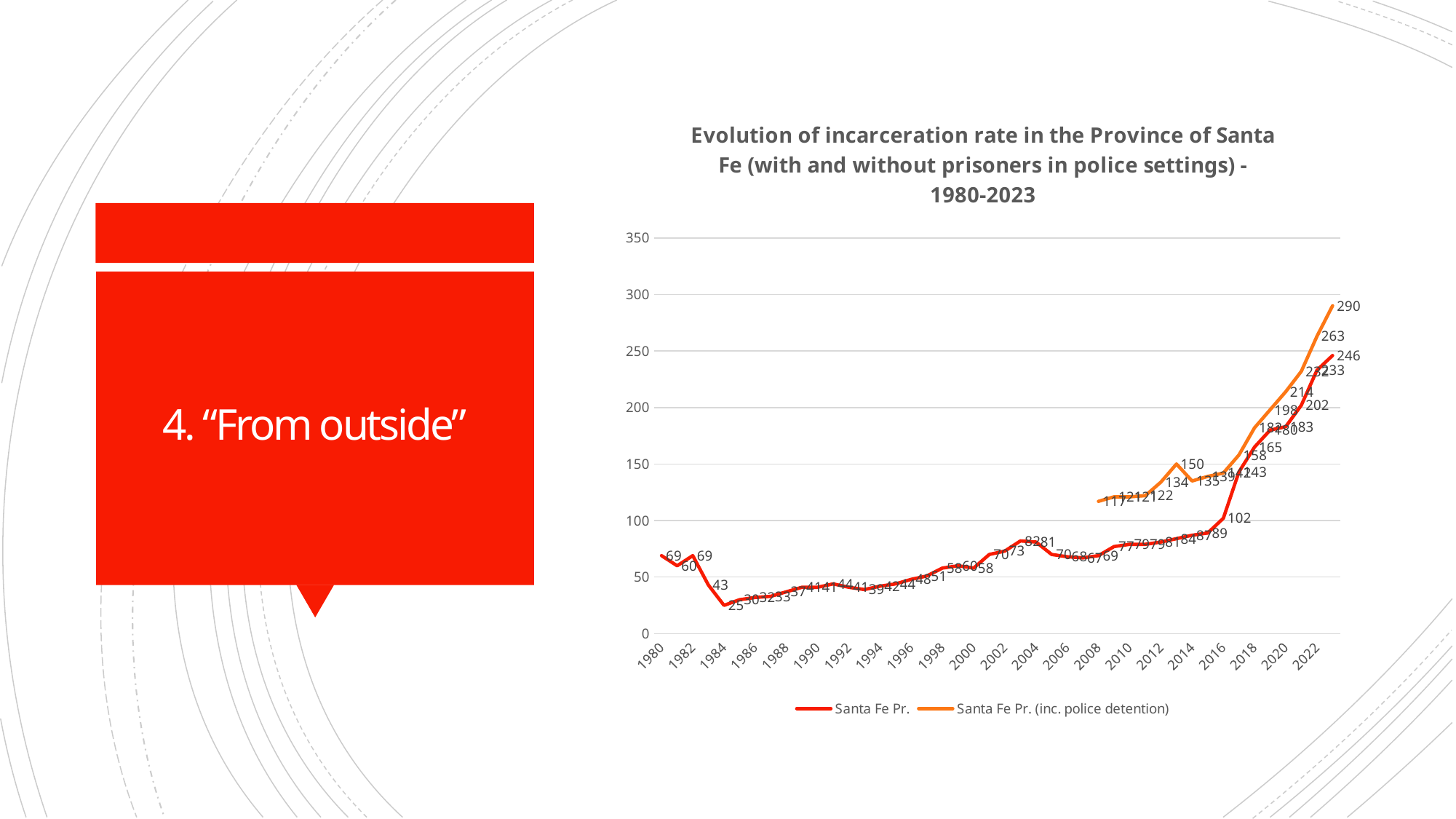
What kind of chart is shown on the slide? line chart In which year does the 'Santa Fe Pr. (inc. police detention)' series reach its highest value? 2023 In which year does the 'Santa Fe Pr.' series reach its lowest value? 1984 What is the value of the 'Santa Fe Pr. (inc. police detention)' series in 2023? 290 What is the value of the 'Santa Fe Pr.' series in 1984? 25 What is the value of the 'Santa Fe Pr.' series in 1980? 69 What is the difference between the 'Santa Fe Pr. (inc. police detention)' value and the 'Santa Fe Pr.' value in 2023? 44 Is the value of the 'Santa Fe Pr.' series in 2000 greater or less than 100? less Does the 'Santa Fe Pr.' series rise or fall between 2016 and 2023? rise What is the value of the 'Santa Fe Pr.' series in 2023? 246 How many series does the legend list? 2 In 2023, which series has the larger value: 'Santa Fe Pr.' or 'Santa Fe Pr. (inc. police detention)'? Santa Fe Pr. (inc. police detention)